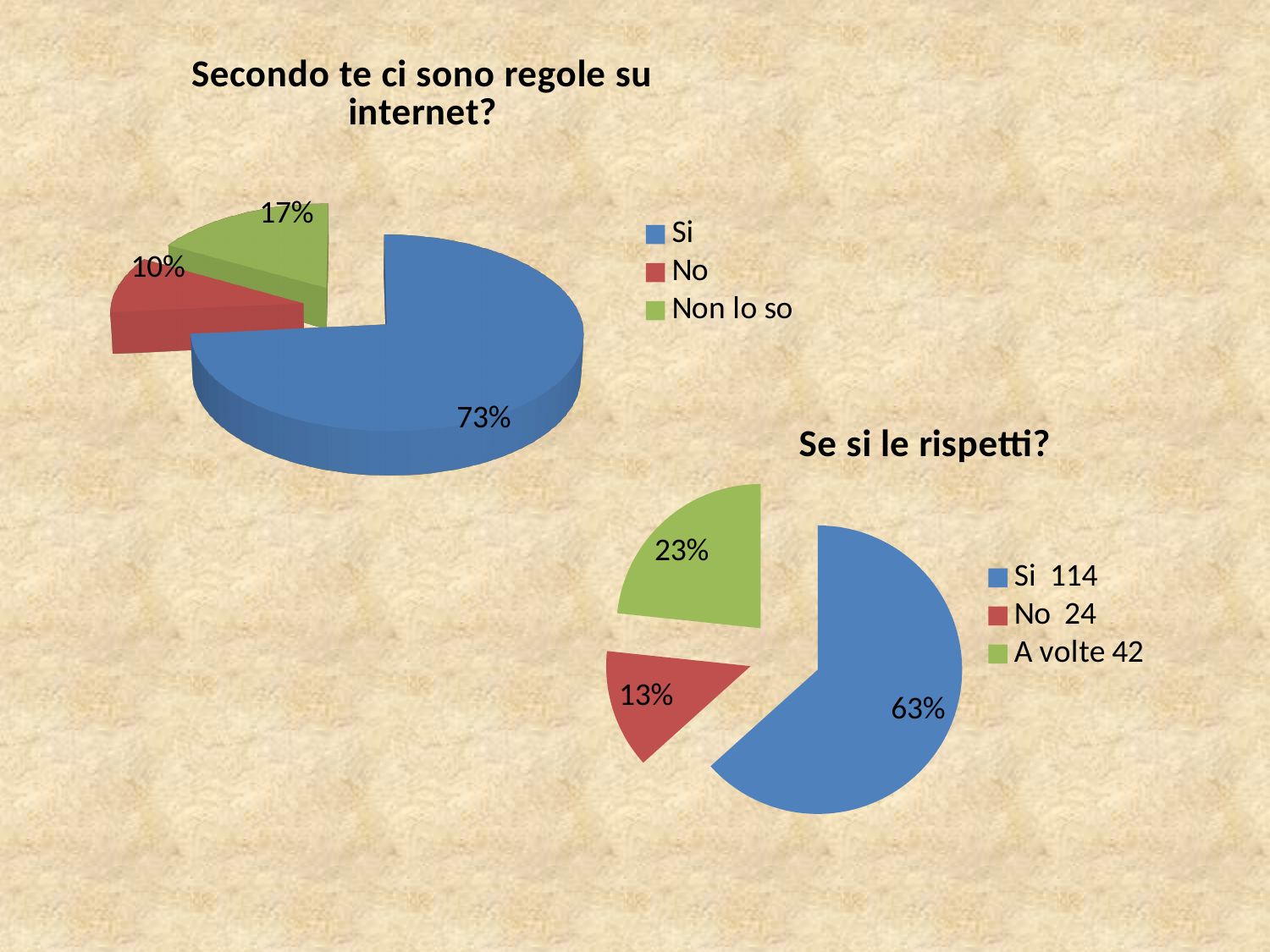
In the chart titled "Secondo te ci sono regole su internet?", what percentage is shown for "Si"? 73% In the chart titled "Secondo te ci sono regole su internet?", what percentage is shown for "Non lo so"? 17% In the chart titled "Se si le rispetti?", which is larger, the slice for "No" or the slice for "A volte"? A volte In the chart titled "Se si le rispetti?", what count does the legend give for "A volte"? 42 What kind of chart is the one titled "Se si le rispetti?"? Pie chart In the chart titled "Secondo te ci sono regole su internet?", what is the difference in percentage points between "Si" and "No"? 63 In the chart titled "Se si le rispetti?", what percentage is shown for "No"? 13% In the chart titled "Secondo te ci sono regole su internet?", how many categories does the legend list? 3 In the chart titled "Se si le rispetti?", which category has the largest slice? Si In the chart titled "Secondo te ci sono regole su internet?", which category has the smallest slice? No In the chart titled "Se si le rispetti?", what colour is the "Si" slice? Blue In the chart titled "Se si le rispetti?", what percentage is shown for "A volte"? 23%